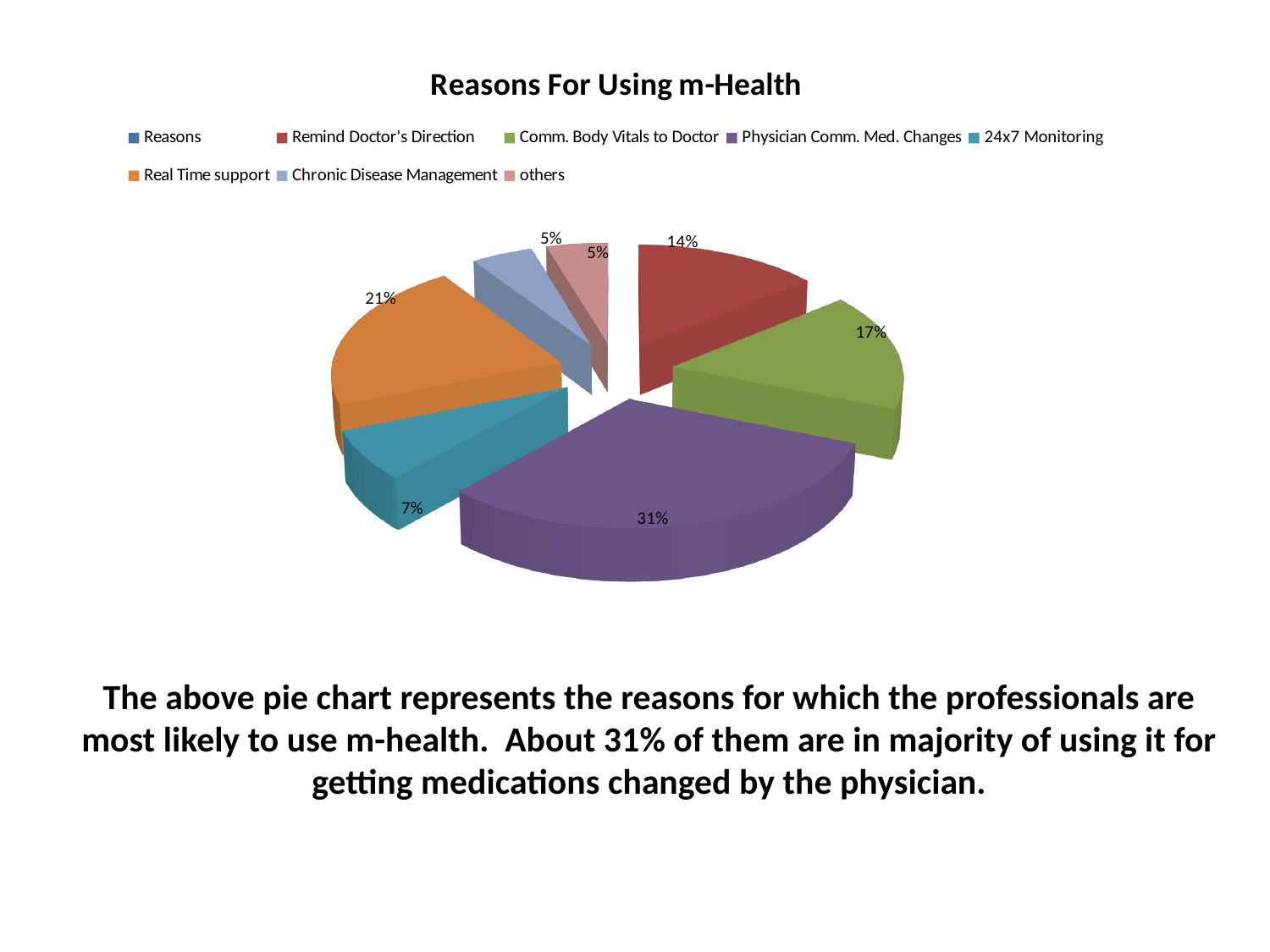
What is the difference between the shares of Comm. Body Vitals to Doctor and Remind Doctor's Direction? 3% What kind of chart is shown on the slide? pie chart What percentage of the pie is Comm. Body Vitals to Doctor? 17% What percentage of the pie is Physician Comm. Med. Changes? 31% What percentage of the pie is 24x7 Monitoring? 7% How many entries does the chart legend list? 8 Which reason has the largest share of the pie? Physician Comm. Med. Changes What percentage of the pie is Remind Doctor's Direction? 14% What is the title of the chart? Reasons For Using m-Health Which has the smaller share, 24x7 Monitoring or Real Time support? 24x7 Monitoring How many percentage points larger is Physician Comm. Med. Changes than Real Time support? 10% What percentage of the pie is Real Time support? 21%